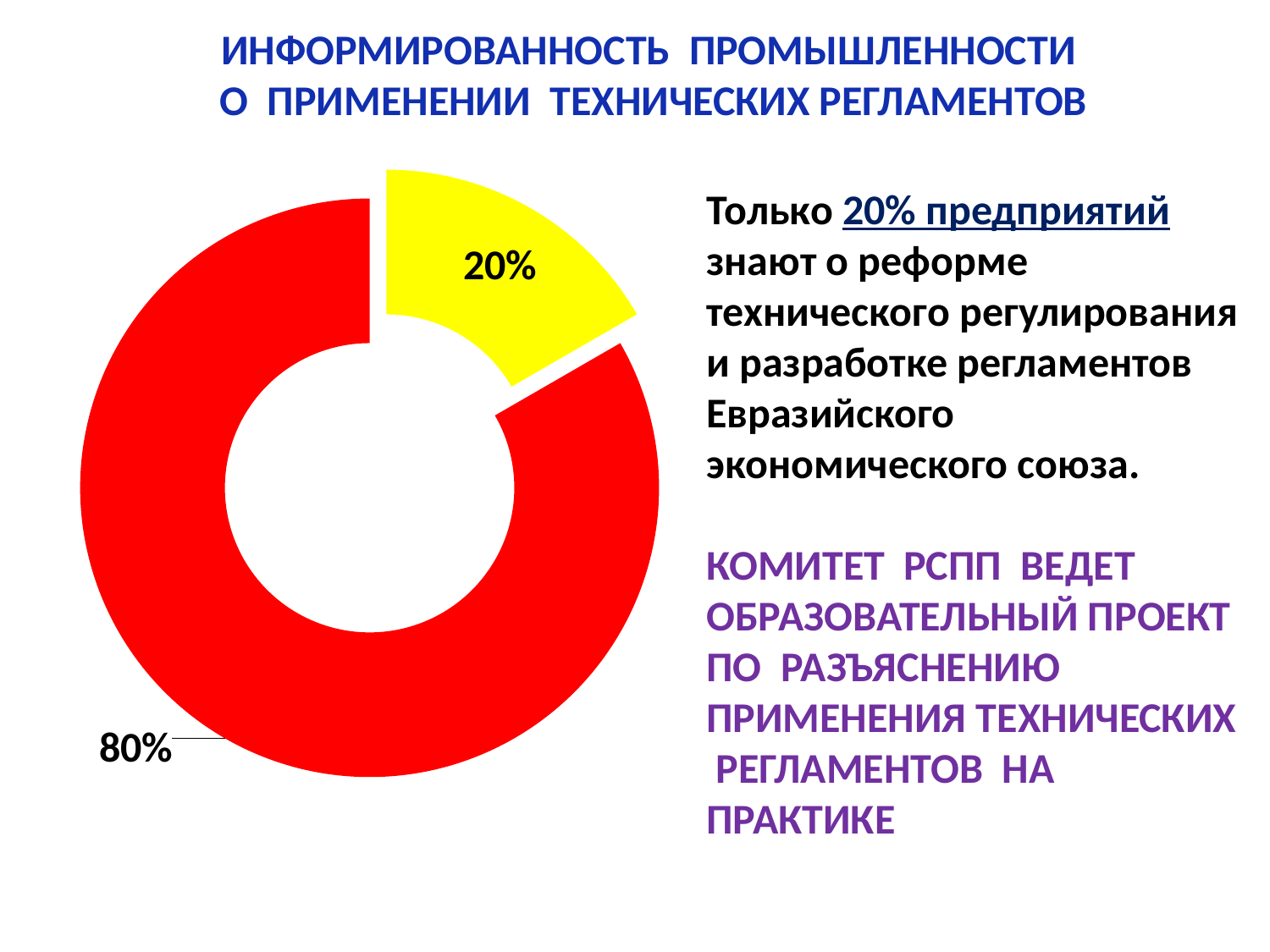
How many slices does the doughnut chart have? 2 What share of the doughnut does the yellow slice represent? 20% Which is larger, the red slice or the yellow slice? The red slice What value is labelled on the yellow slice of the doughnut chart? 20% What do the two slices of the doughnut chart add up to? 100% Which slice of the doughnut chart is the smallest? The yellow slice (20%) What colour is the 80% slice of the doughnut chart? Red What is the difference between the red slice and the yellow slice? 60% What value is labelled on the red slice of the doughnut chart? 80% According to the slide text, what percentage of enterprises know about the technical regulation reform? 20% Which slice of the doughnut chart is the largest? The red slice (80%) What kind of chart is shown on the slide? Doughnut (pie) chart